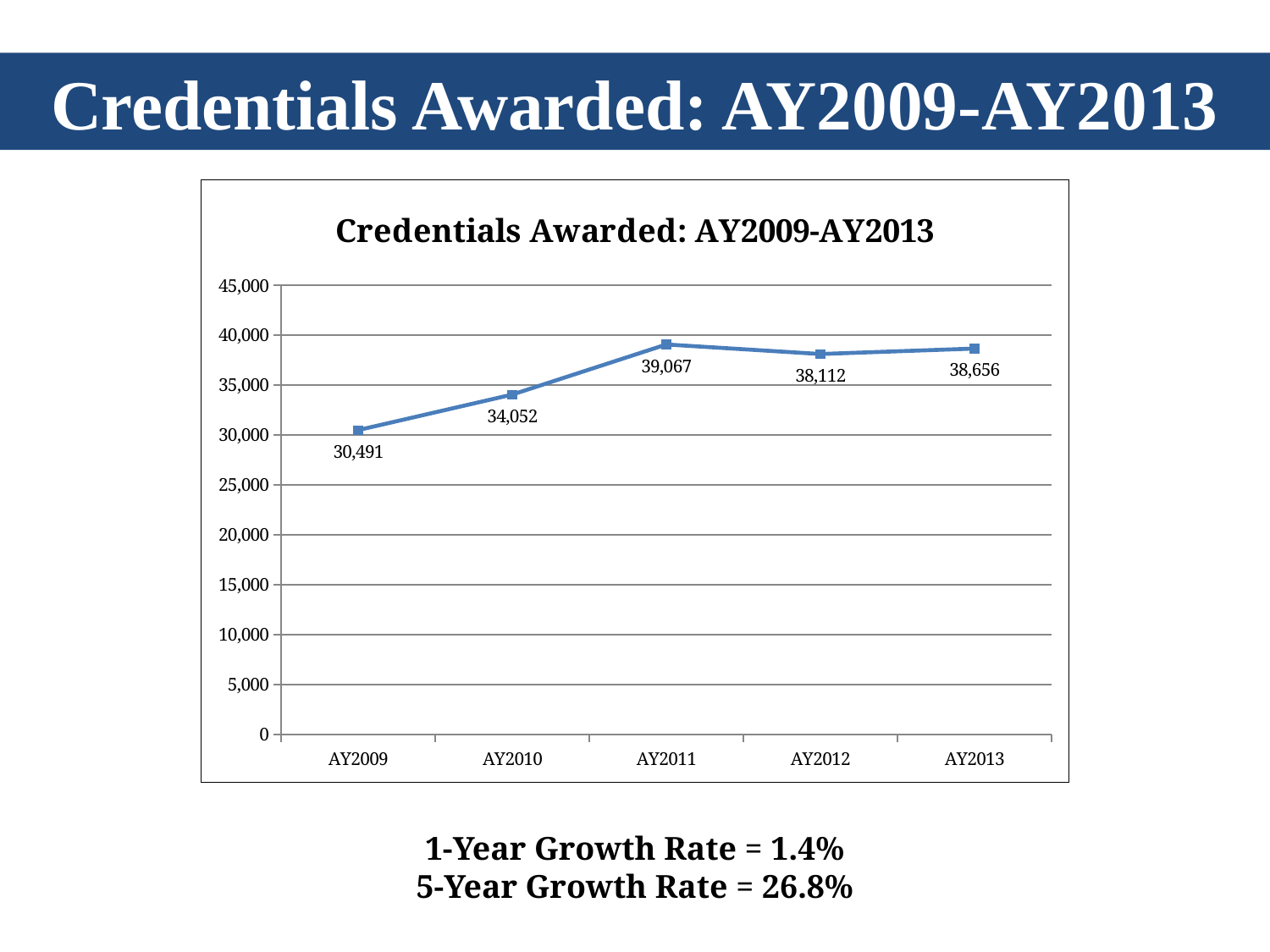
Which year has the highest number of credentials awarded? AY2011 What is the value for AY2013? 38,656 Which is larger, the value for AY2010 or the value for AY2012? AY2012 What kind of chart is shown? line chart What is the difference between the values for AY2013 and AY2012? 544 What is the title of the chart? Credentials Awarded: AY2009-AY2013 How many years are plotted on the chart? 5 Which year has the lowest number of credentials awarded? AY2009 Is the value for AY2010 greater or less than 35,000? less What is the difference between the values for AY2011 and AY2009? 8,576 What is the value for AY2009? 30,491 What is the value for AY2011? 39,067